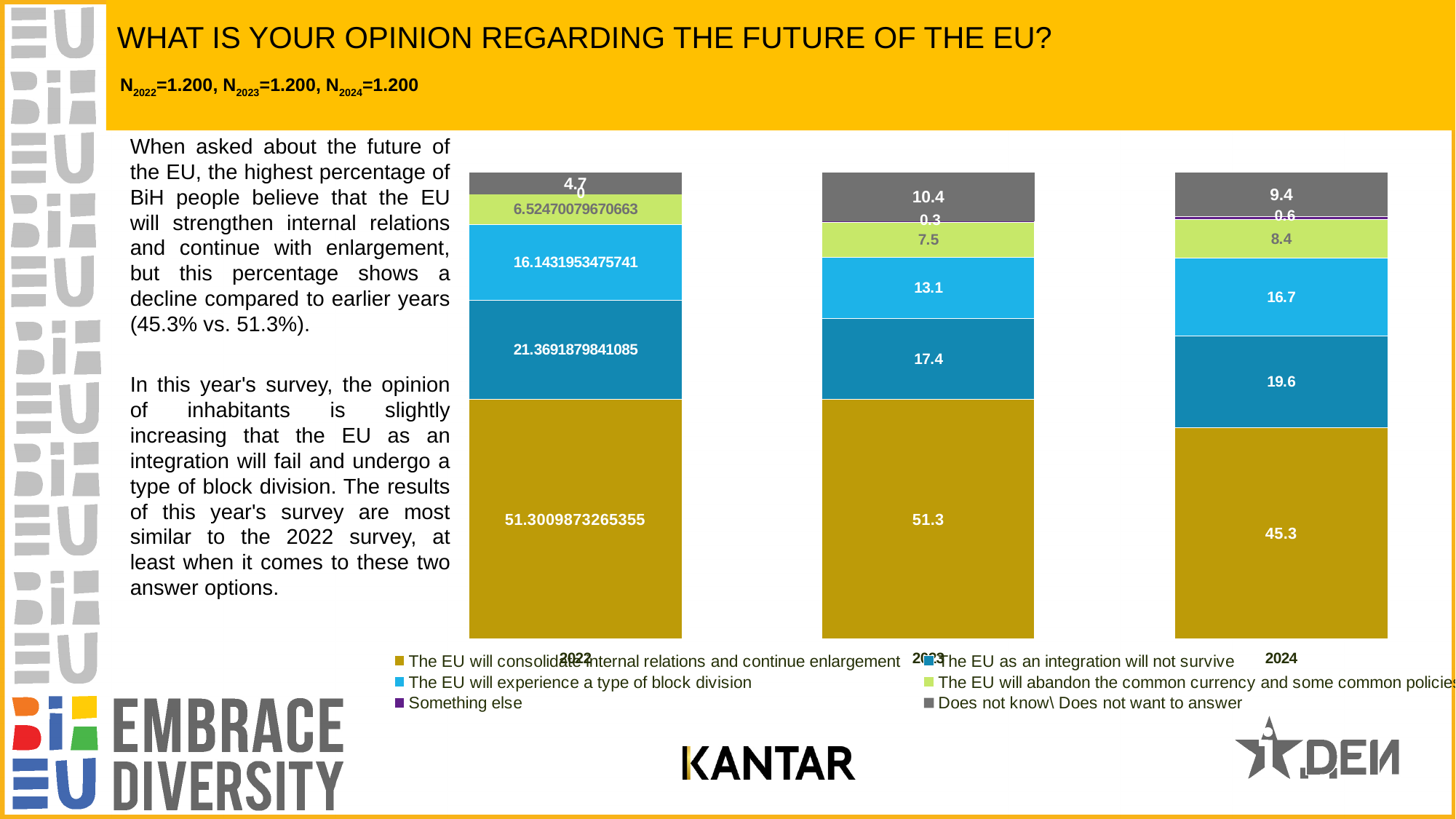
What is the value for 'The EU will experience a type of block division' in 2023? 13.1 What is the value for 'Something else' in 2024? 0.6 Which is larger: the 2023 or the 2024 value for 'The EU as an integration will not survive'? 2024 What is the total of the stacked bar for 2024? 100 Which year has the lowest value for 'The EU will consolidate internal relations and continue enlargement'? 2024 What is the value for 'The EU as an integration will not survive' in 2023? 17.4 What is the value for 'The EU will consolidate internal relations and continue enlargement' in 2024? 45.3 How many years (bars) are shown on the x axis of the chart? 3 What type of chart is shown on the slide? Stacked bar chart What is the difference between the 2023 and 2024 values for 'The EU will consolidate internal relations and continue enlargement'? 6.0 How many series does the chart legend list? 6 What is the value for 'Does not know\ Does not want to answer' in 2024? 9.4